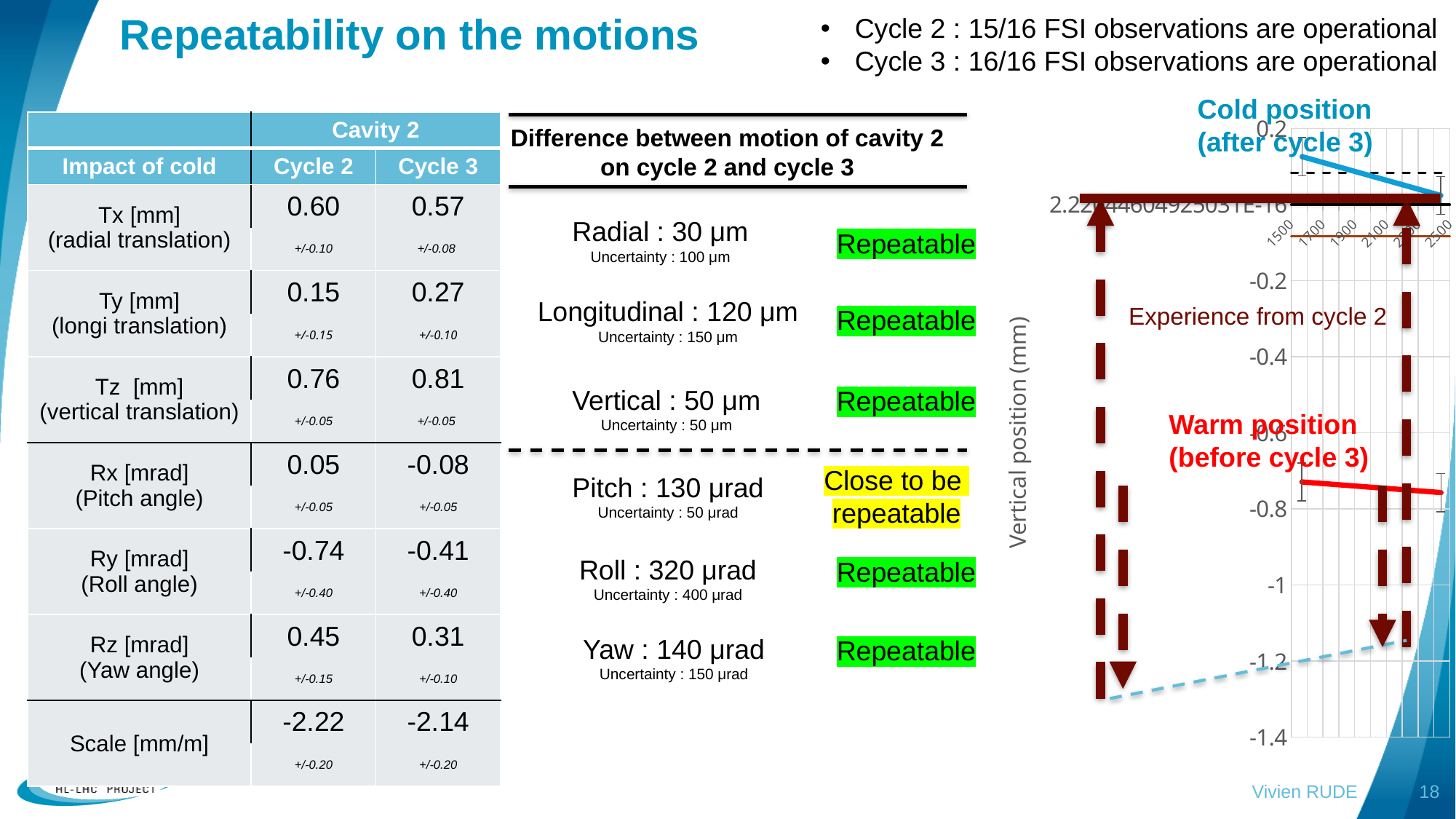
In the chart on the right, is the cold position (after cycle 3) greater or less than -0.2 mm? greater In the chart on the right, is the warm position (before cycle 3) greater or less than -1 mm? greater In the chart on the right, what colour is the line for the warm position (before cycle 3)? red In the chart on the right, does the cold position (after cycle 3) line rise or fall from left to right? fall What is the lowest tick value shown on the vertical axis of the chart on the right? -1.4 In the chart on the right, is the warm position (before cycle 3) greater or less than -0.6 mm? less In the chart on the right, which line is higher: the cold position (after cycle 3) or the warm position (before cycle 3)? Cold position (after cycle 3) What is the label of the vertical axis of the chart on the right? Vertical position (mm) How many tick labels are shown on the horizontal axis of the chart on the right? 6 What kind of chart is shown on the right of the slide? line chart